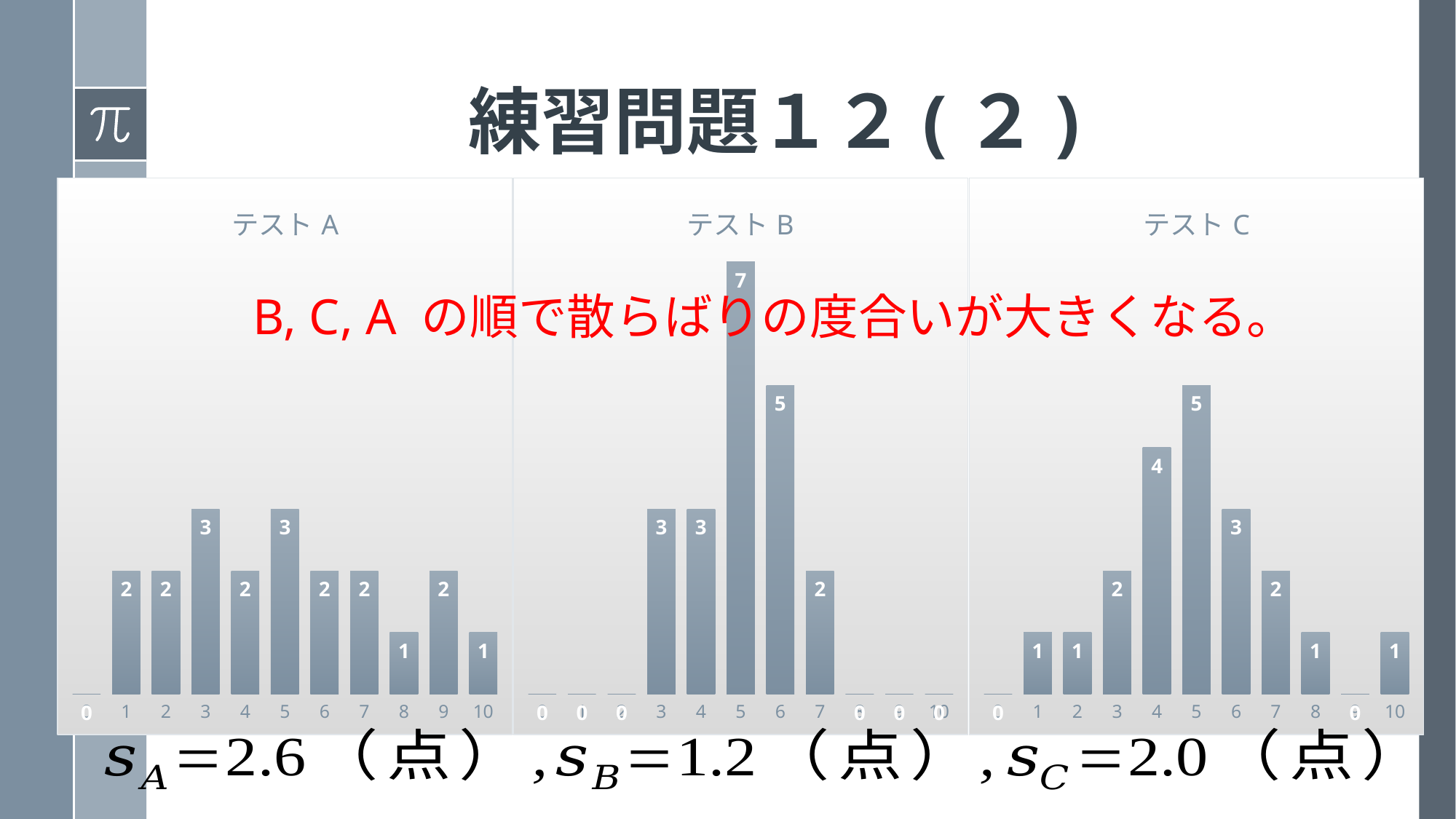
In the テスト C chart, what is the value for category 4? 4 In the テスト A chart, which is larger, the value for category 3 or the value for category 8? category 3 In the テスト B chart, which category has the highest value? 5 What kind of chart is the テスト B chart? bar chart In the テスト B chart, what is the difference between the values for category 5 and category 6? 2 In the テスト B chart, what is the value for category 5? 7 In the テスト C chart, which category has the highest value? 5 How many categories are shown on the x axis of the テスト A chart? 11 What is the title of the leftmost chart on the slide? テスト A In the テスト C chart, which is larger, the value for category 6 or the value for category 7? category 6 In the テスト C chart, what is the difference between the values for category 5 and category 3? 3 In the テスト A chart, what is the value for category 8? 1